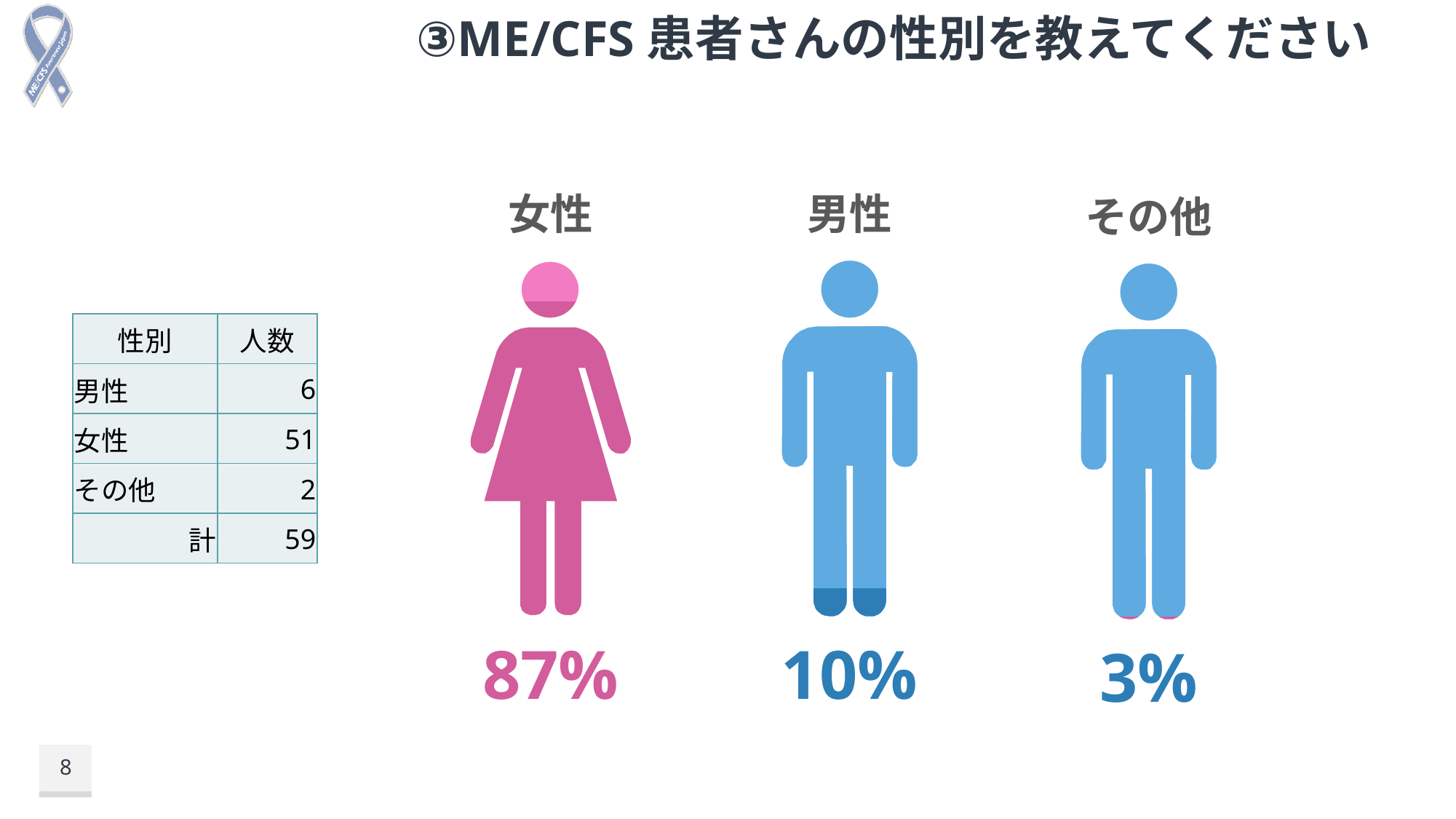
Which gender category has the highest percentage? 女性 How many gender categories are shown in the pictogram? 3 What colour is the 女性 (female) figure in the pictogram? Pink What is the difference in percentage points between 女性 and 男性? 77 What kind of chart is used to show the gender breakdown? Pictogram (icon chart) What percentage is shown for その他 (other) in the pictogram? 3% According to the table, what is the total number of respondents (計)? 59 What percentage is shown for 女性 (female) in the pictogram? 87% What percentage is shown for 男性 (male) in the pictogram? 10% Which is larger, the percentage for 男性 or for その他? 男性 According to the table, how many respondents are 女性? 51 Which gender category has the lowest percentage? その他